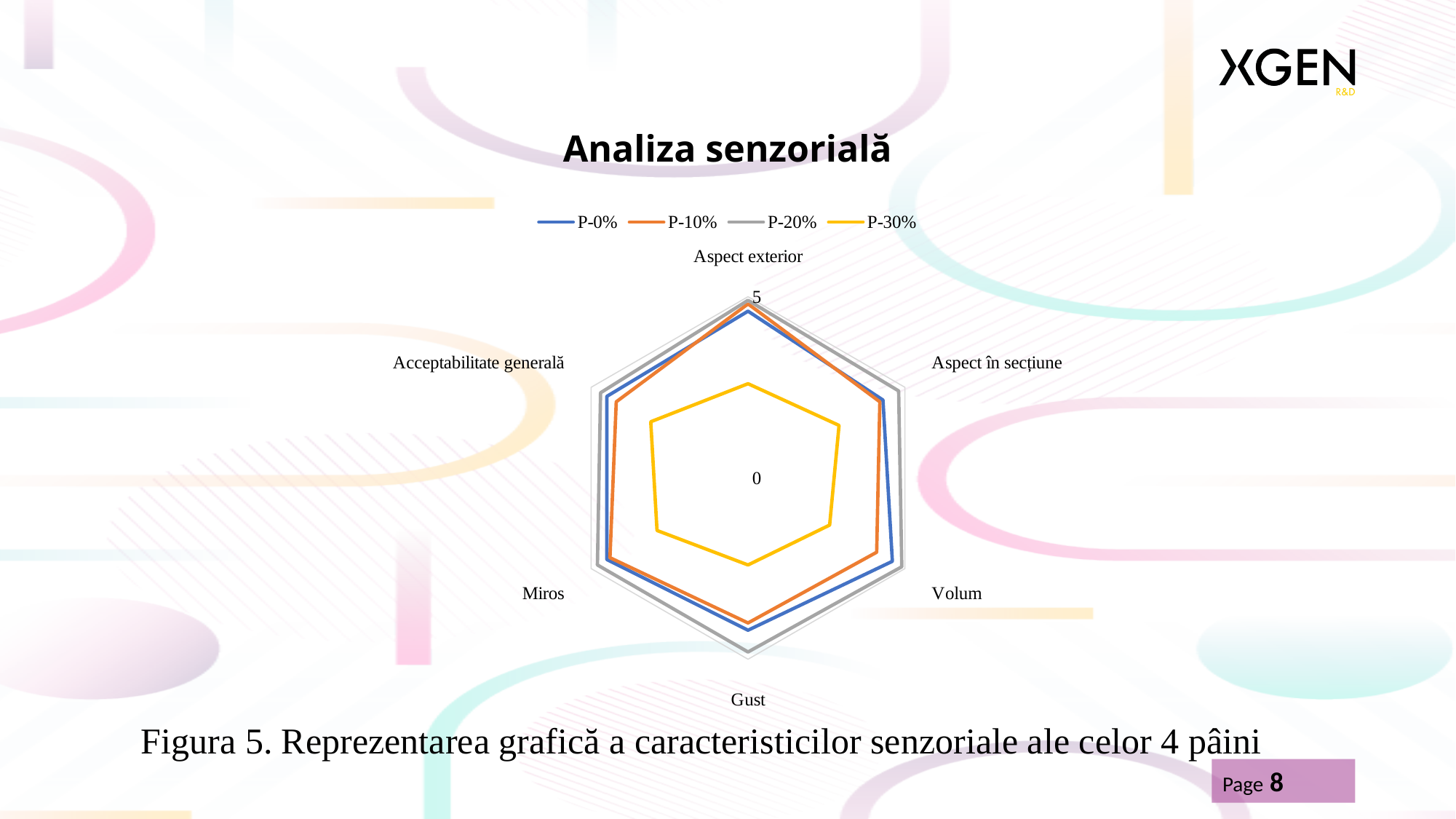
Which is larger for Gust: the value for P-0% or the value for P-30%? P-0% How many series does the legend list? 4 What kind of chart is shown on the slide? Radar chart Which is larger for Volum: the value for P-0% or the value for P-10%? P-0% How many categories (axes) does the radar chart have? 6 Which series has the lowest values across all categories? P-30% What is the title of the chart? Analiza senzorială Is the value for P-30% on Aspect exterior greater or less than 5? less Is the value for P-10% on Miros greater or less than 0? greater Which series has the highest values across all categories? P-20% What is the maximum value shown on the chart's axis scale? 5